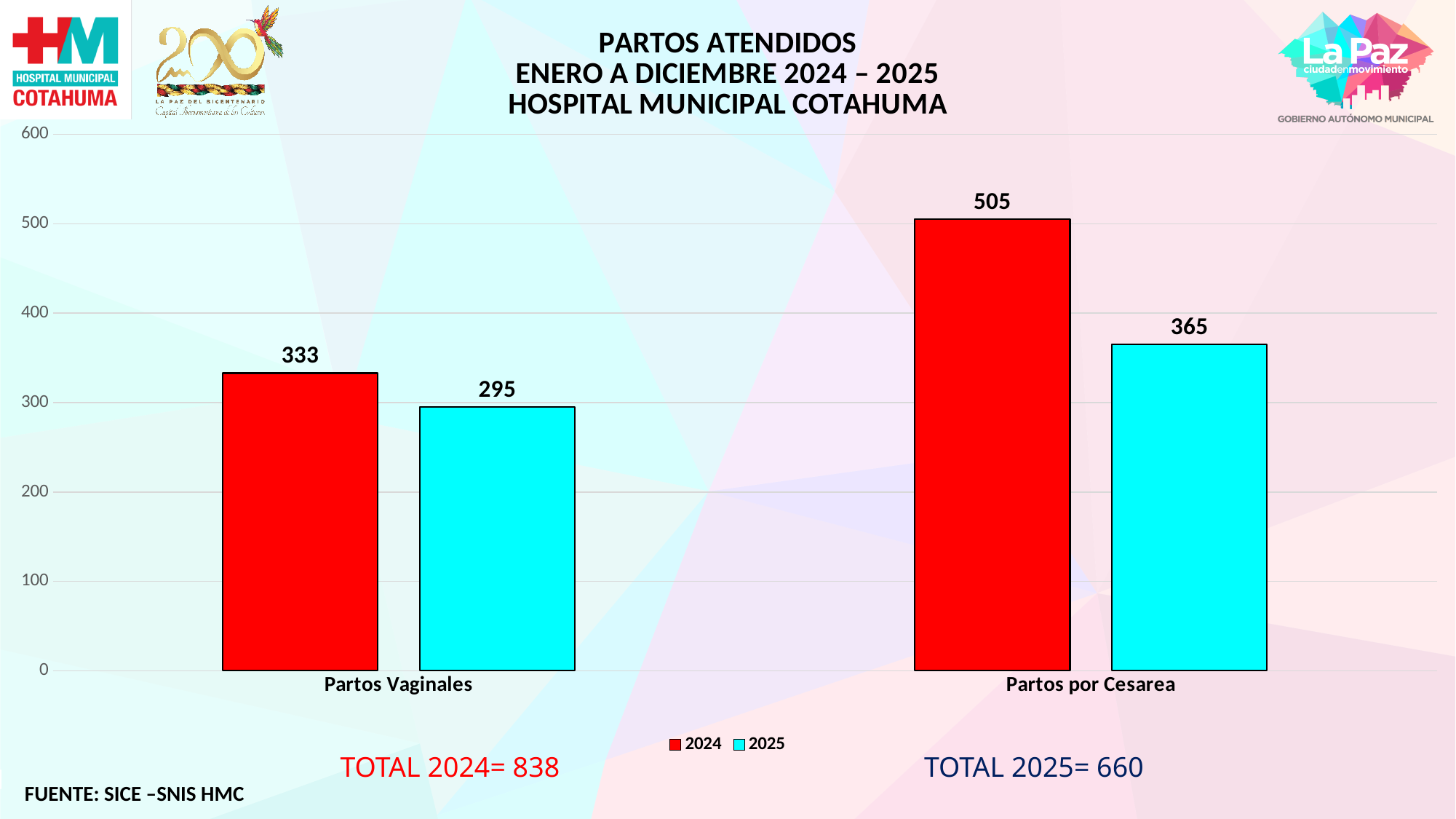
Is the value for Partos por Cesarea in 2024 greater or less than 400? greater What is the value for Partos Vaginales in 2024? 333 What is the value for Partos por Cesarea in 2025? 365 What is the value for Partos Vaginales in 2025? 295 Which category has the lowest value for the 2025 series? Partos Vaginales What kind of chart is shown on the slide? Bar chart How many series does the legend list? 2 What is the difference between the 2024 and 2025 values for Partos por Cesarea? 140 Which is larger for Partos Vaginales, the 2024 value or the 2025 value? 2024 Which category has the highest value for the 2024 series? Partos por Cesarea What is the difference between the 2024 and 2025 values for Partos Vaginales? 38 How many categories are shown on the x axis? 2